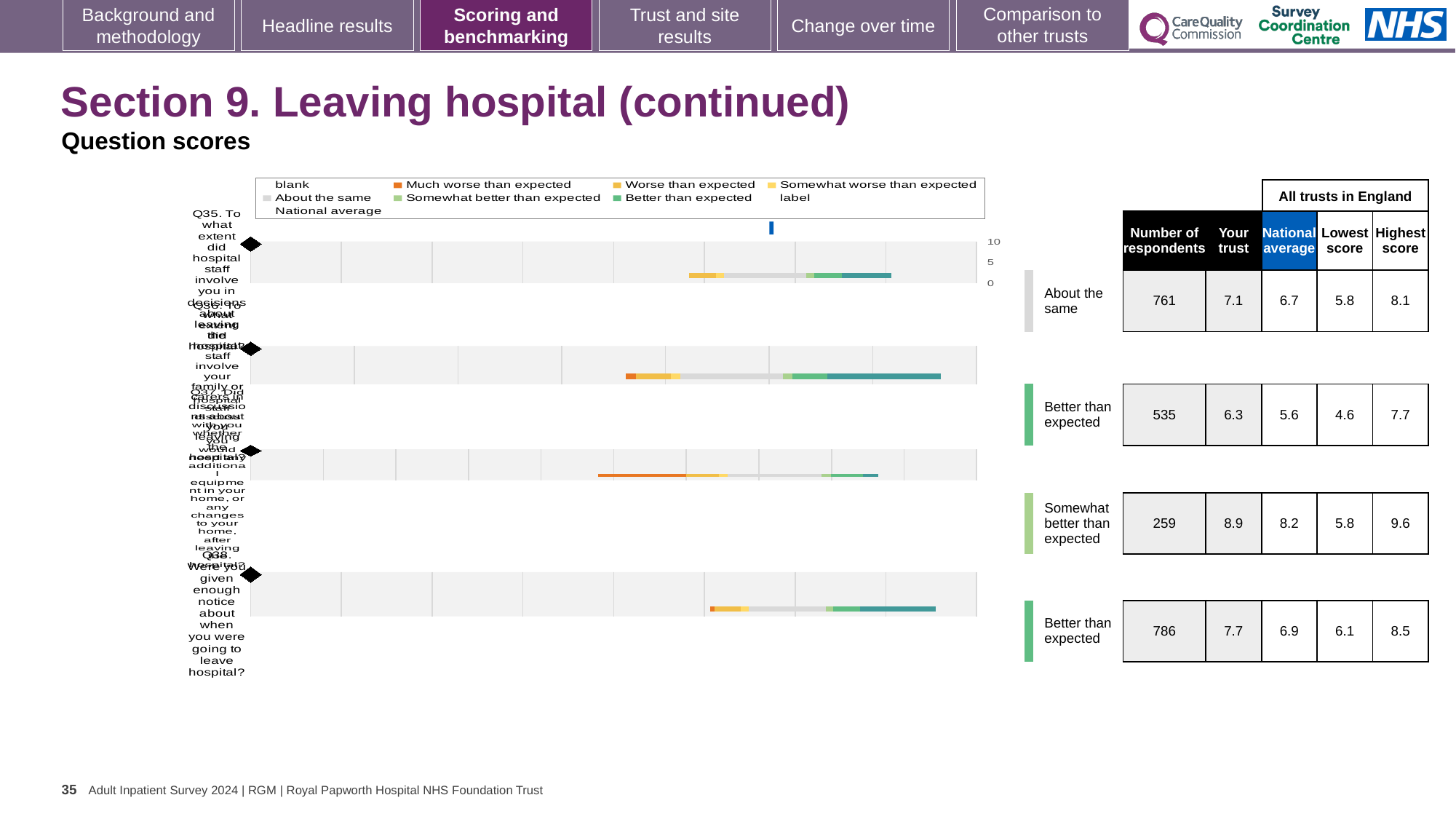
What kind of chart is shown on the slide? bar chart In the table beside the chart, what is the 'Your trust' score for the first row (Q35, 'About the same')? 7.1 In the table beside the chart, what is the number of respondents for Q35 (the first row, 'About the same')? 761 In the table beside the chart, is the 'Your trust' score for the first row (Q35) higher or lower than its national average? higher In the table beside the chart, which row has the lowest number of respondents? Somewhat better than expected (259) In the table beside the chart, which row has the highest 'Your trust' score? Somewhat better than expected (8.9) Which legend entry is shown in light grey? About the same In the table beside the chart, what is the national average for the third row ('Somewhat better than expected')? 8.2 How many questions (rows) are plotted in the chart? 4 In the table beside the chart, what is the highest score for the last row (Q38, 'Better than expected')? 8.5 In the table beside the chart, what is the difference between the 'Your trust' score and the national average for the last row (Q38)? 0.8 Which legend entry is shown in orange? Much worse than expected